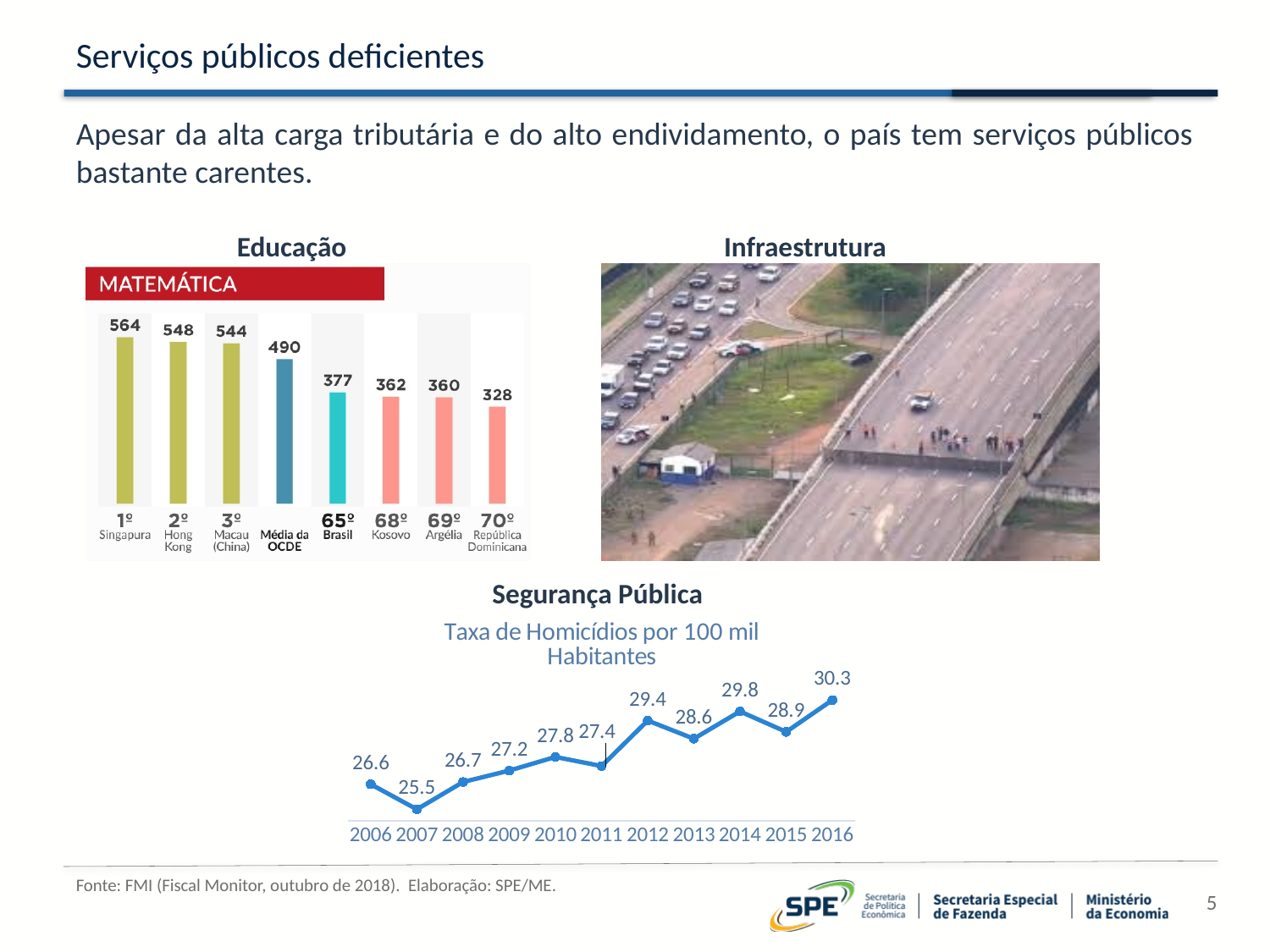
In the Taxa de Homicídios por 100 mil Habitantes chart, what is the value for 2016? 30.3 In the MATEMÁTICA bar chart, how many bars are shown? 8 In the Taxa de Homicídios por 100 mil Habitantes chart, how many years are plotted? 11 In the MATEMÁTICA bar chart, which category has the lowest value? República Dominicana What kind of chart is the MATEMÁTICA chart? Bar chart In the MATEMÁTICA bar chart, what is the value for Brasil? 377 In the MATEMÁTICA bar chart, what is the difference between the value for Média da OCDE and the value for Brasil? 113 In the Taxa de Homicídios por 100 mil Habitantes chart, is the value for 2012 or 2013 larger? 2012 In the MATEMÁTICA bar chart, what is the value for Média da OCDE? 490 In the Taxa de Homicídios por 100 mil Habitantes chart, which year has the lowest value? 2007 What kind of chart is the Taxa de Homicídios por 100 mil Habitantes chart? Line chart In the MATEMÁTICA bar chart, which category has the highest value? Singapura